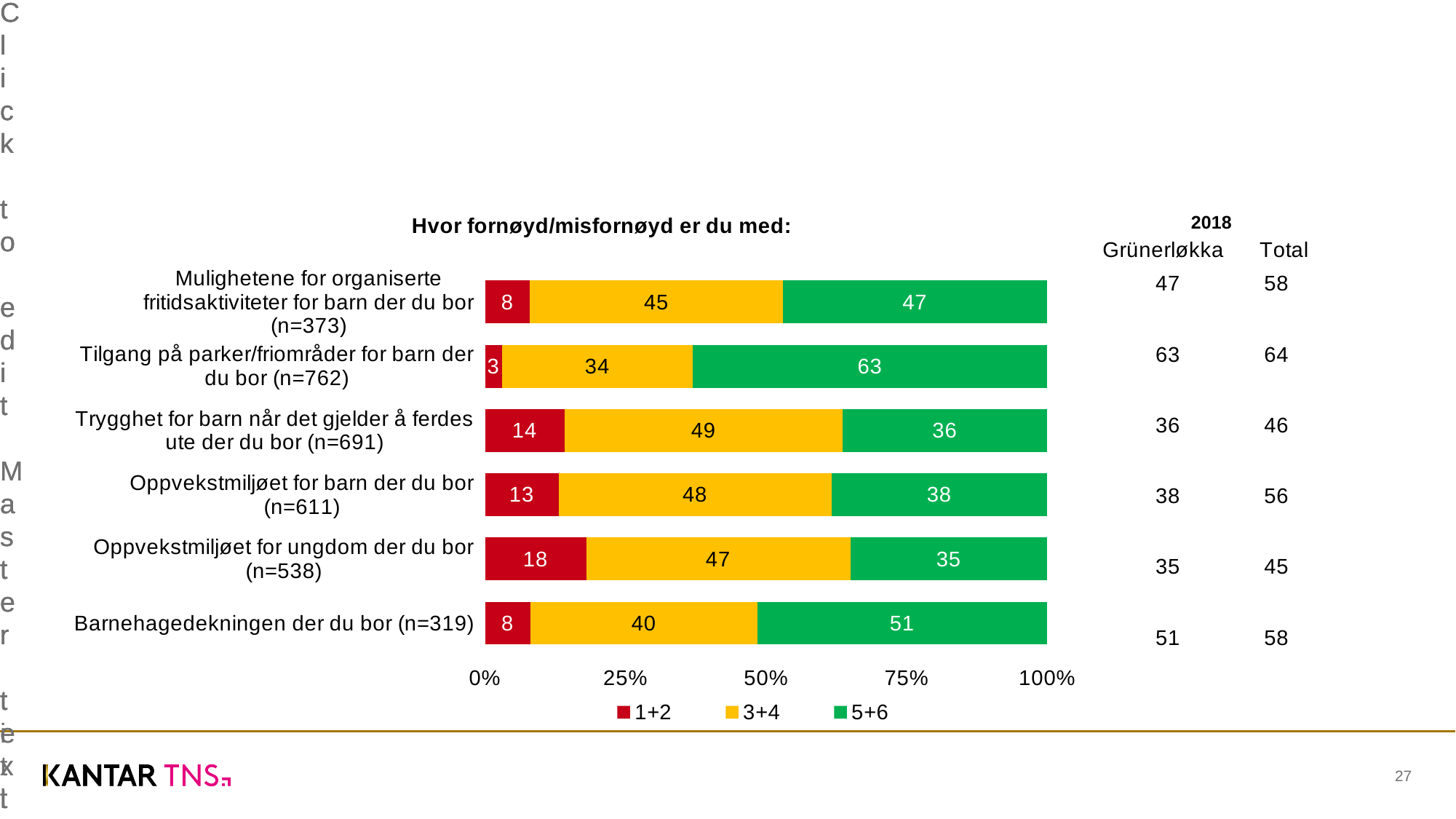
What is the value of the 5+6 series for "Tilgang på parker/friområder for barn der du bor (n=762)"? 63 Which category has the lowest value in the 1+2 series? Tilgang på parker/friområder for barn der du bor (n=762) What kind of chart is shown on the slide? Stacked bar chart What is the difference between the 5+6 values for "Barnehagedekningen der du bor (n=319)" and "Oppvekstmiljøet for ungdom der du bor (n=538)"? 16 What is the total of the stacked bar for "Trygghet for barn når det gjelder å ferdes ute der du bor (n=691)"? 99 Which category has the highest value in the 5+6 series? Tilgang på parker/friområder for barn der du bor (n=762) What is the title of the chart? Hvor fornøyd/misfornøyd er du med: What is the value of the 3+4 series for "Trygghet for barn når det gjelder å ferdes ute der du bor (n=691)"? 49 What is the value of the 1+2 series for "Oppvekstmiljøet for ungdom der du bor (n=538)"? 18 How many series does the legend list? 3 Which is larger: the 3+4 value for "Oppvekstmiljøet for barn der du bor (n=611)" or the 3+4 value for "Barnehagedekningen der du bor (n=319)"? Oppvekstmiljøet for barn der du bor (n=611) How many categories are shown in the chart? 6